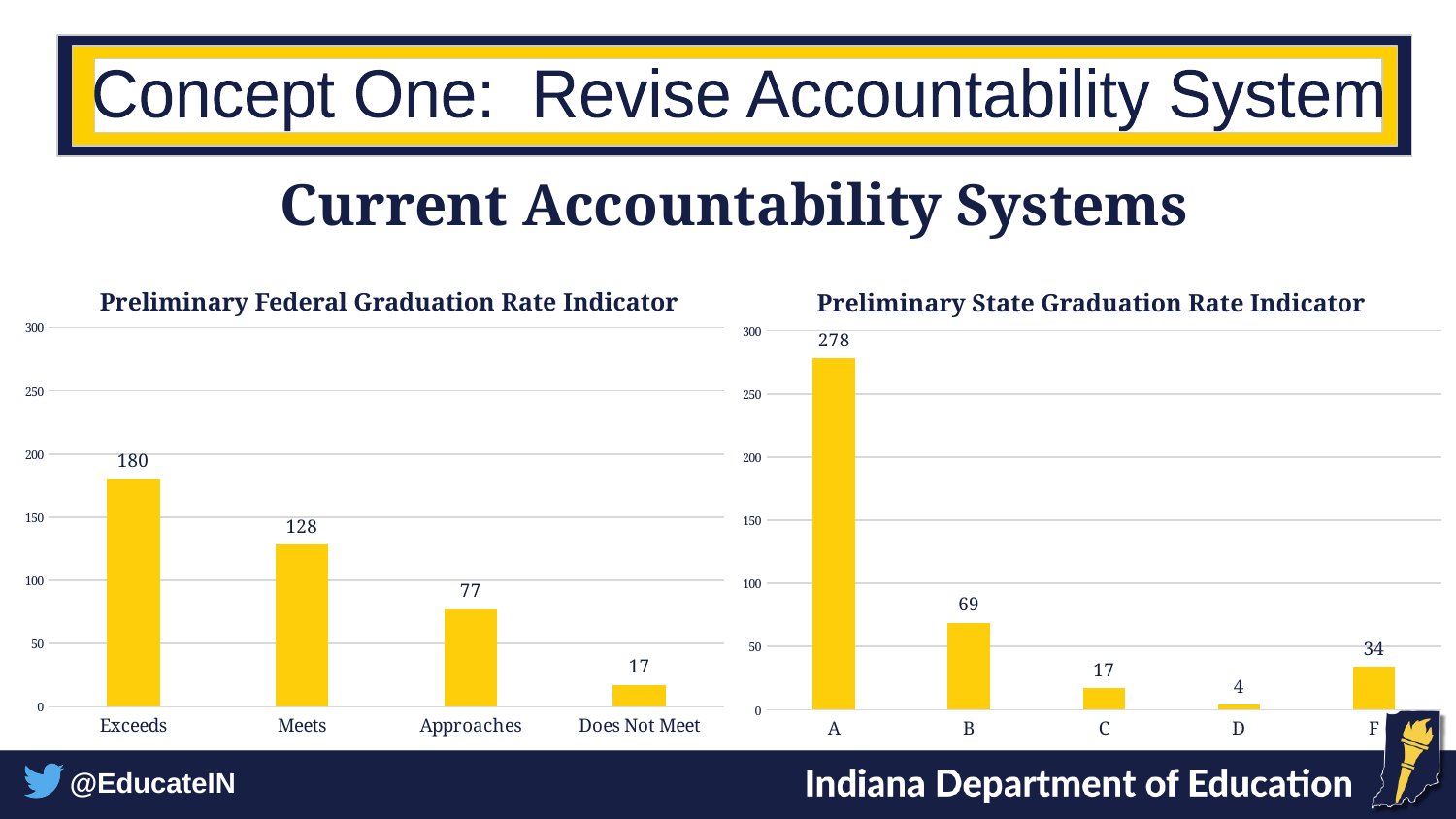
In the Preliminary Federal Graduation Rate Indicator chart, which category has the lowest value? Does Not Meet What kind of chart is the Preliminary State Graduation Rate Indicator chart? Bar chart In the Preliminary State Graduation Rate Indicator chart, what is the value for D? 4 In the Preliminary State Graduation Rate Indicator chart, what is the value for A? 278 In the Preliminary State Graduation Rate Indicator chart, which category has the lowest value? D In the Preliminary Federal Graduation Rate Indicator chart, what is the difference between the values for Exceeds and Meets? 52 In the Preliminary State Graduation Rate Indicator chart, how many categories are shown? 5 In the Preliminary Federal Graduation Rate Indicator chart, how many categories are shown? 4 In the Preliminary State Graduation Rate Indicator chart, which is larger, the value for C or the value for F? F In the Preliminary Federal Graduation Rate Indicator chart, which category has the highest value? Exceeds In the Preliminary State Graduation Rate Indicator chart, what is the difference between the values for B and C? 52 In the Preliminary Federal Graduation Rate Indicator chart, what is the value for Meets? 128